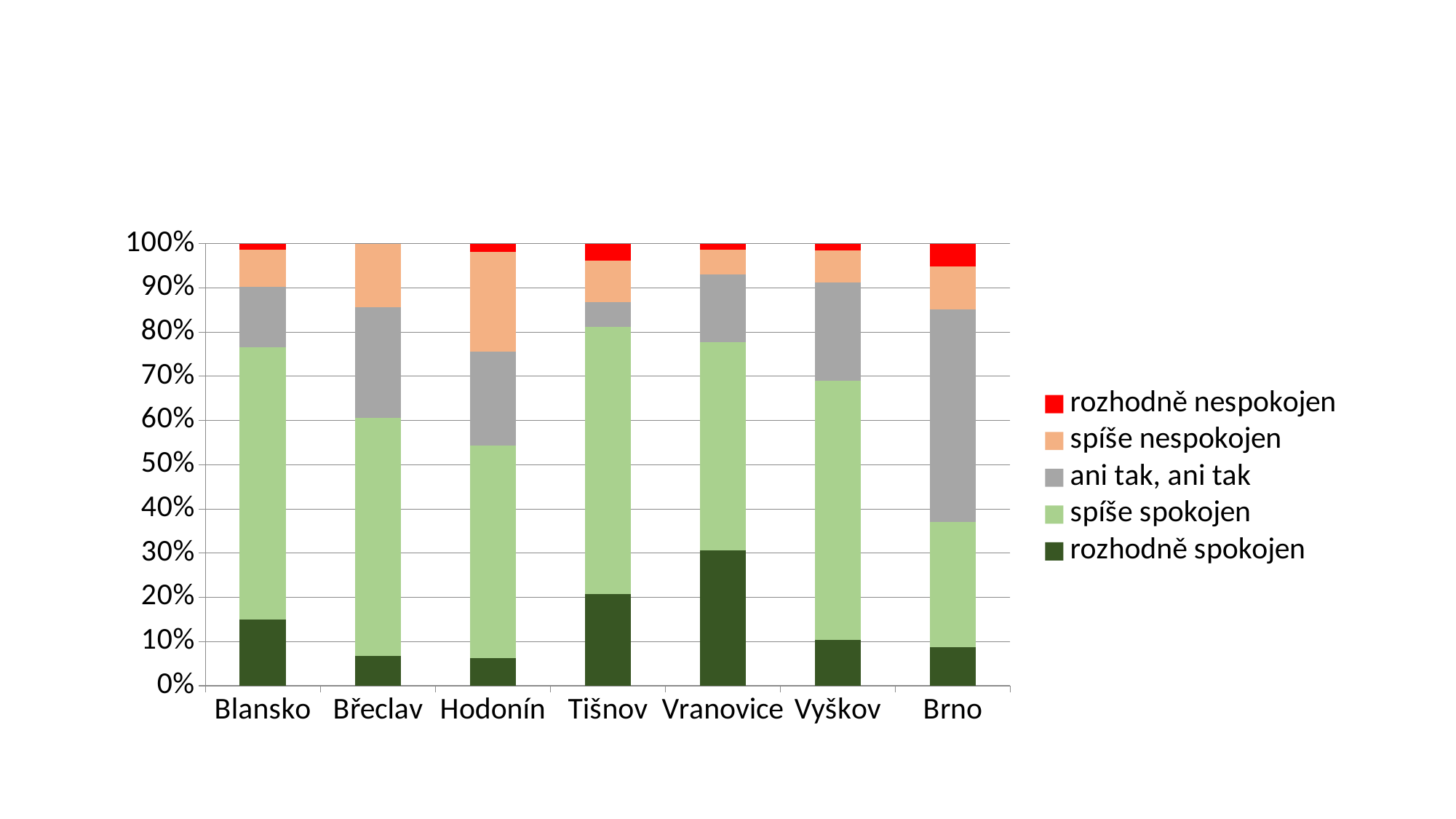
Which category has the largest 'ani tak, ani tak' segment? Brno How many series does the legend list? 5 Which category has the largest 'rozhodně spokojen' segment? Vranovice What kind of chart is shown on the slide? stacked bar chart Which has a larger 'rozhodně spokojen' segment, Tišnov or Blansko? Tišnov Is the 'rozhodně spokojen' value for Vranovice greater or less than 20%? greater What is the total height of the Brno stacked bar? 100% Is the 'rozhodně spokojen' value for Blansko greater or less than 20%? less How many categories are shown on the x axis? 7 Which category has the largest 'rozhodně nespokojen' segment? Brno Which legend entry is shown in red? rozhodně nespokojen Is the 'ani tak, ani tak' value for Brno greater or less than 40%? greater